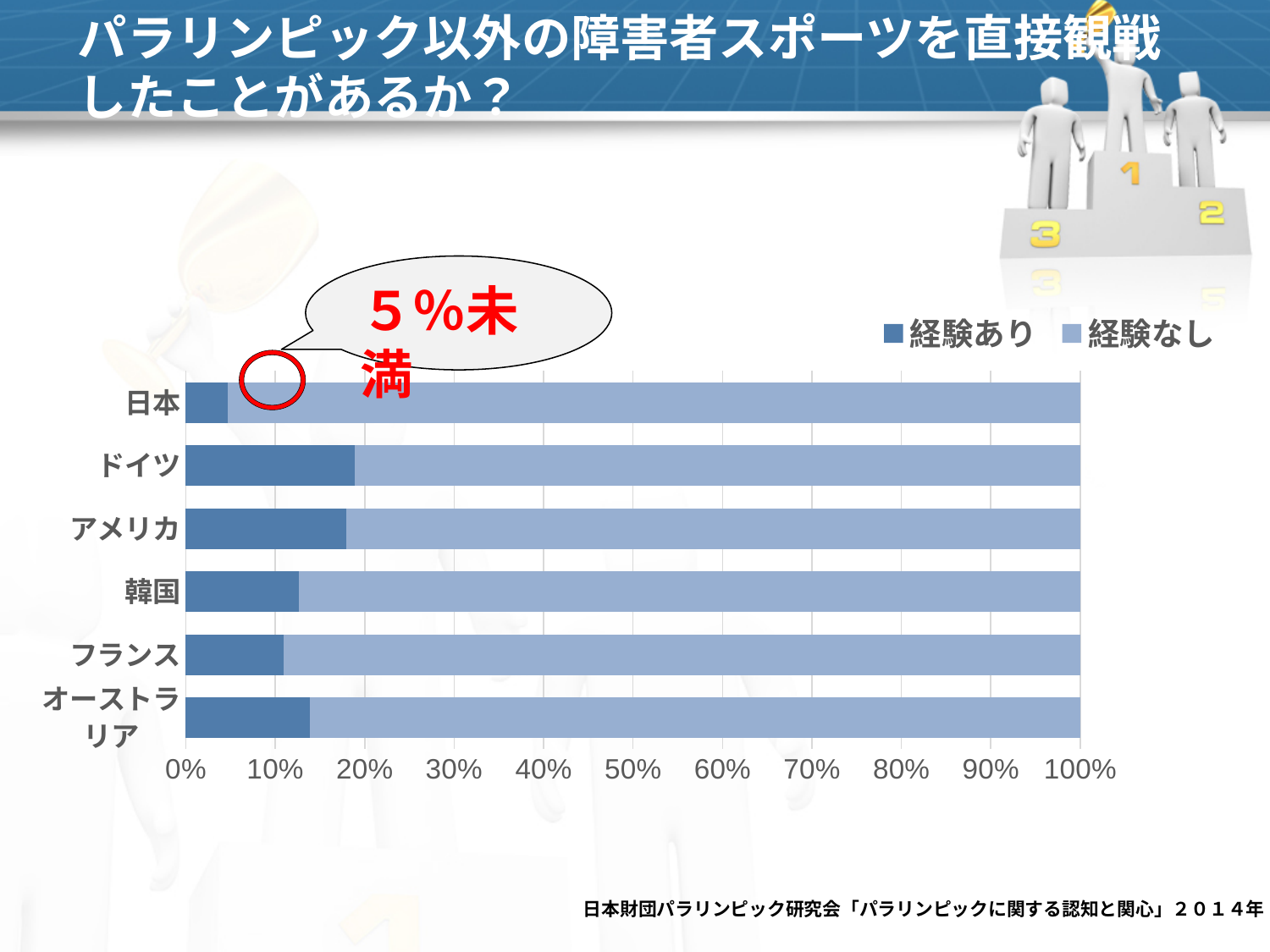
What does the callout pointing at the 日本 bar say? ５％未満 How many countries are listed on the chart's vertical axis? 6 How many series does the chart legend list? 2 What kind of chart is shown on the slide? Stacked bar chart Which country has the smallest 経験あり share? 日本 Is the 経験あり value for 日本 greater or less than 10%? less Is the 経験あり value for オーストラリア greater or less than 10%? greater What are the two legend entries of the chart? 経験あり, 経験なし Is the 経験あり value for ドイツ greater or less than 10%? greater Which has the larger 経験あり share, ドイツ or 日本? ドイツ